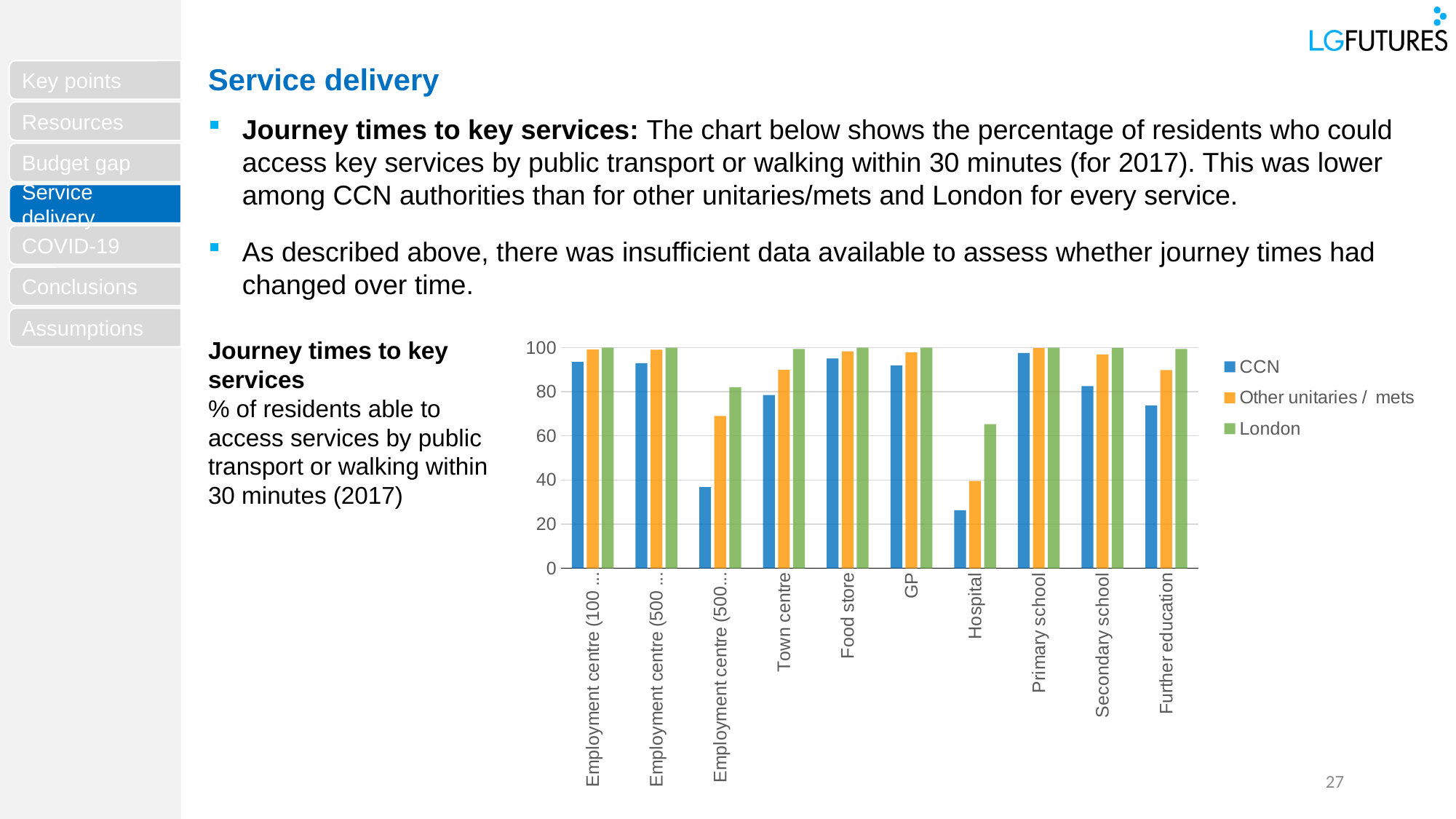
Which series is shown in green in the chart legend? London How many service categories are plotted along the x axis of the chart? 10 For Hospital, which is larger: the CCN value or the London value? London Which service category has the lowest CCN value in the chart? Hospital What kind of chart is shown on the slide? bar chart What is the title of the chart? Journey times to key services Is the CCN value for Further education greater or less than 80? less For Town centre, which is larger: the CCN value or the Other unitaries / mets value? Other unitaries / mets How many series does the chart legend list? 3 Is the CCN value for Food store greater or less than 80? greater Is the CCN value for Hospital greater or less than 40? less